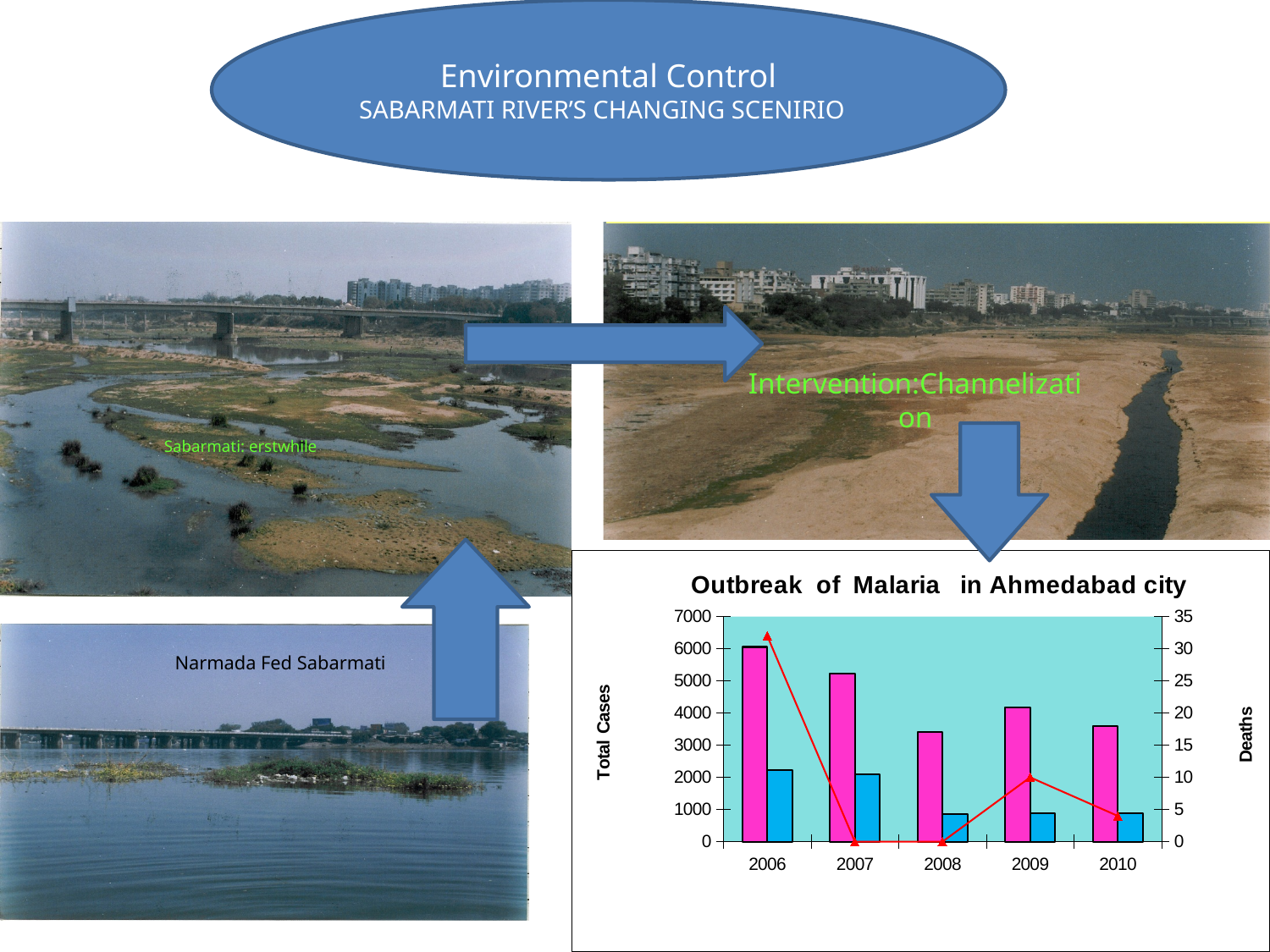
In the malaria chart, is the blue bar for 2006 greater or less than 2000? greater What kind of chart is used to show the malaria outbreak data? bar chart with a line In the malaria chart, what is the value of the red line (Deaths) for 2007? 0 What is the label of the right-hand vertical axis of the malaria chart? Deaths In the malaria chart, which year has the shortest pink bar? 2008 In the malaria chart, which is larger: the pink bar for 2007 or the pink bar for 2009? 2007 In the malaria chart, is the blue bar for 2009 greater or less than 1000? less In the malaria chart, which year has the tallest pink bar? 2006 What is the title of the chart on the slide? Outbreak of Malaria in Ahmedabad city In the malaria chart, is the pink bar for 2008 greater or less than 4000? less How many years are shown on the x axis of the malaria chart? 5